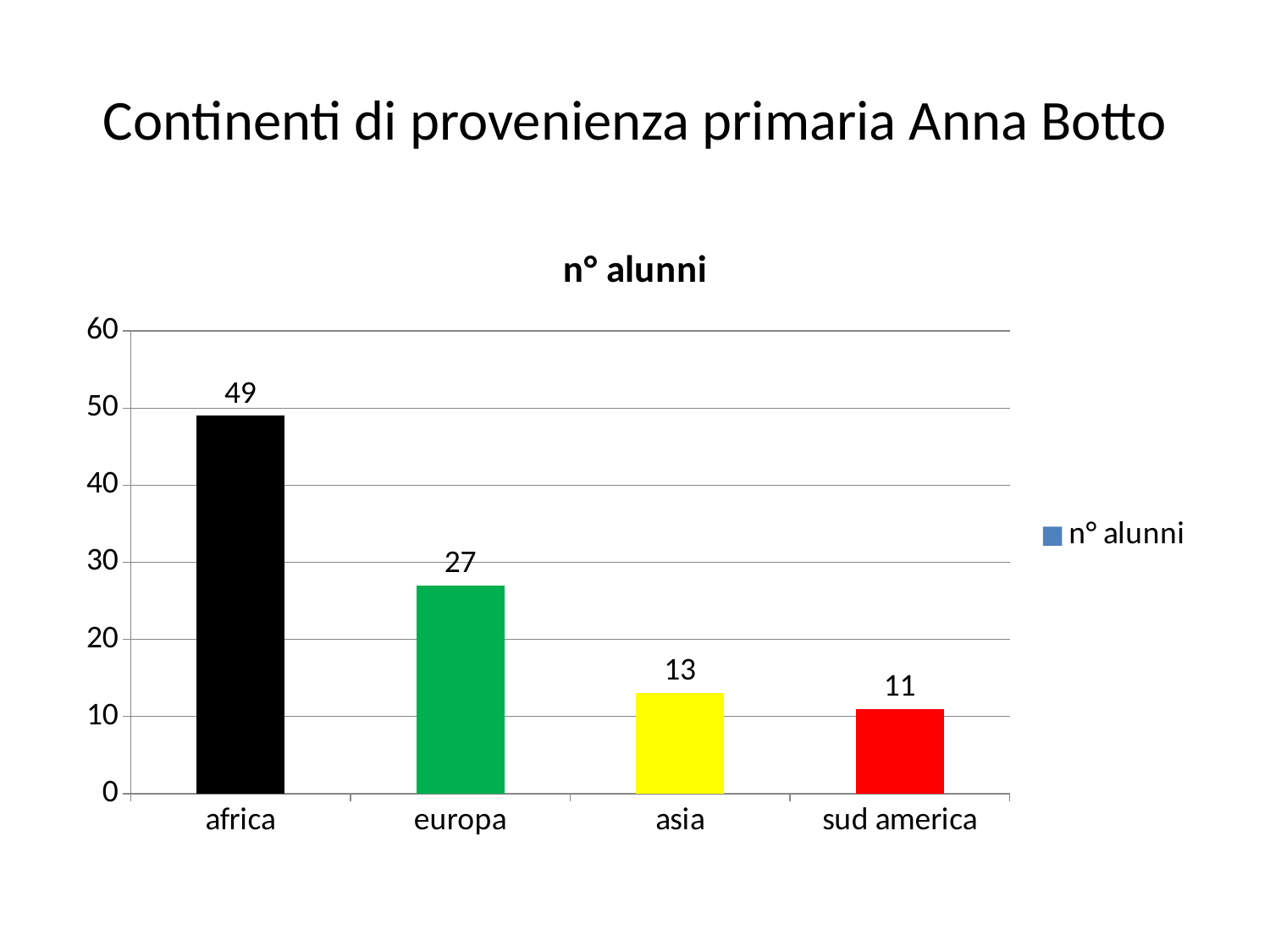
What is the difference between the values for africa and europa? 22 What is the title of the chart? n° alunni What is the value for sud america? 11 What is the value for asia? 13 Which is larger, the value for europa or the value for asia? europa Which category has the highest value? africa Is the value for africa greater or less than 40? greater What kind of chart is shown on the slide? bar chart Which category has the lowest value? sud america What is the value for africa? 49 What is the value for europa? 27 How many categories are shown on the x axis? 4